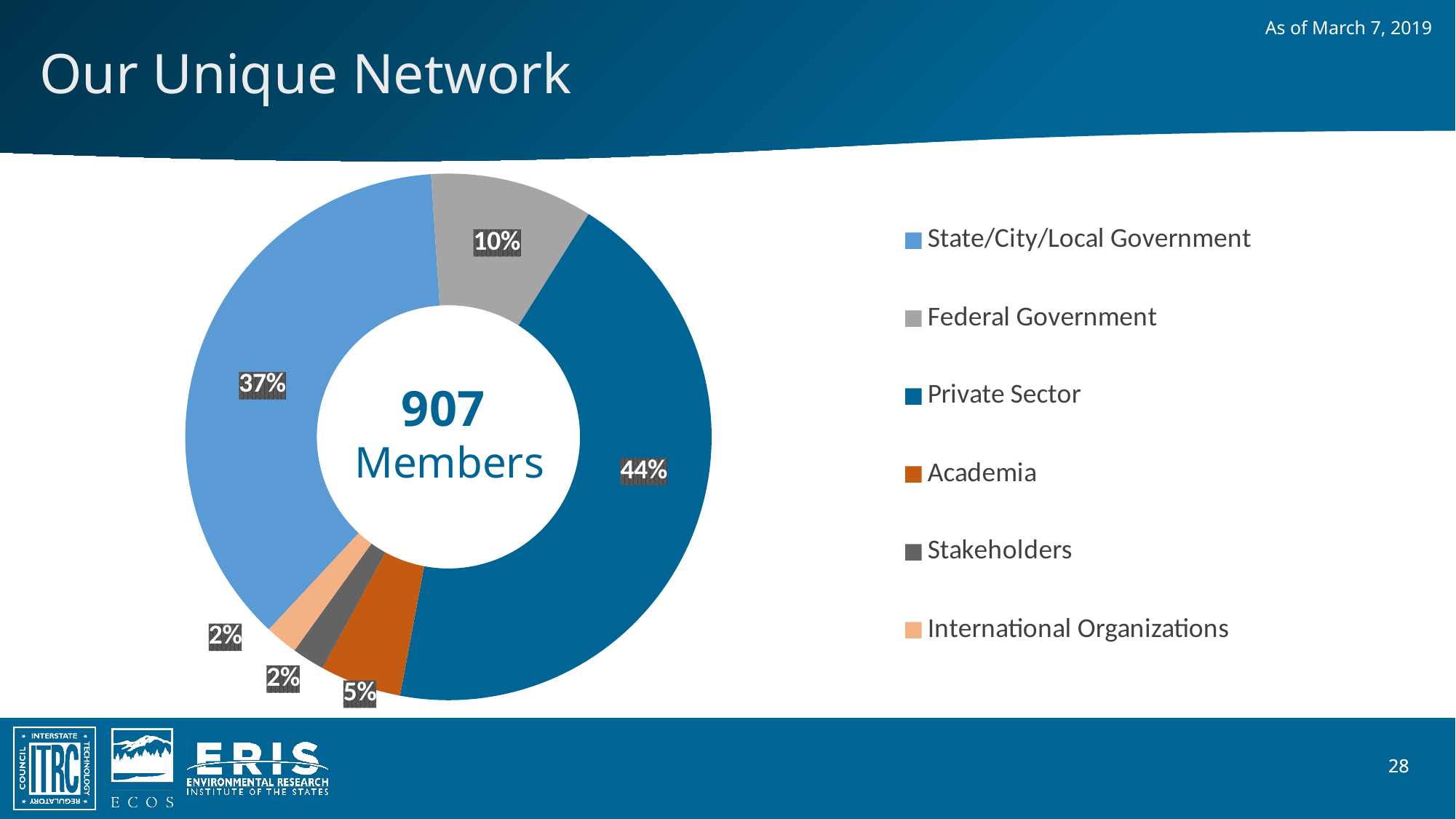
What percentage of members are from Academia? 5% Which category makes up the largest share of the network? Private Sector How many categories does the chart show? 6 What share of the network is State/City/Local Government? 37% What percentage of members are from the Federal Government? 10% How many percentage points larger is the Private Sector share than the State/City/Local Government share? 7 What percentage of members are from the Private Sector? 44% Which is larger, the Federal Government share or the Academia share? Federal Government What percentage of members are Stakeholders? 2% What kind of chart is shown on the slide? doughnut chart Which category is shown in grey in the legend? Federal Government What total number of members is shown in the centre of the chart? 907